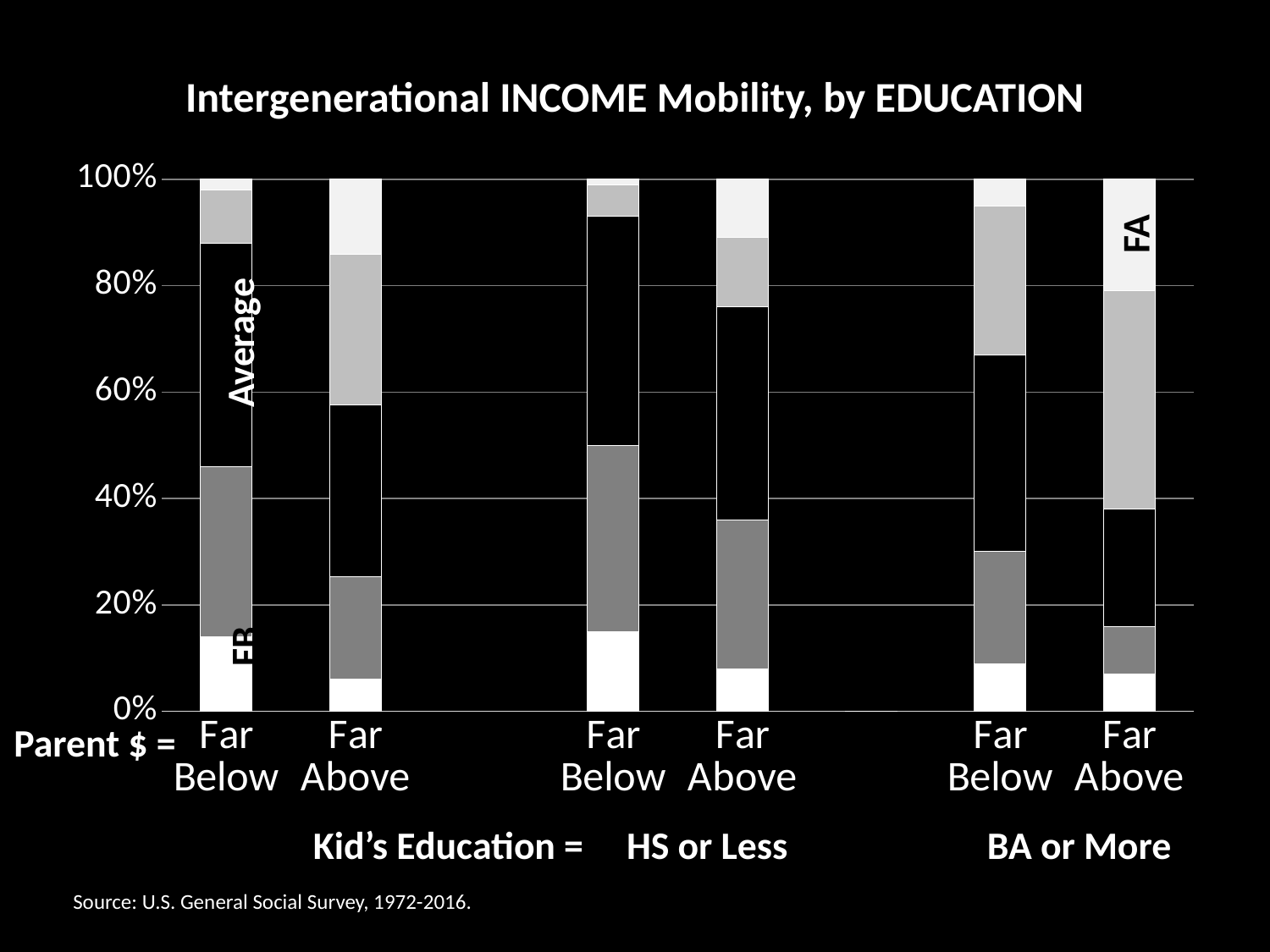
What kind of chart is shown on the slide? Stacked bar chart In the leftmost 'Far Below' bar, is the top of the black (Average) segment greater or less than 80%? greater Which bar has the larger top (FA) segment: the 'HS or Less' 'Far Above' bar or the 'BA or More' 'Far Above' bar? BA or More Far Above In the 'BA or More' 'Far Above' bar, is the top of the black (Average) segment greater or less than 60%? less How many bars are plotted in the chart? 6 What is the highest value shown on the vertical axis? 100% Which bar has the larger light gray segment: the 'HS or Less' 'Far Above' bar or the 'BA or More' 'Far Above' bar? BA or More Far Above In the 'HS or Less' 'Far Below' bar, is the top of the black (Average) segment greater or less than 80%? greater What is the title of the chart? Intergenerational INCOME Mobility, by EDUCATION Which bar has the larger white (FB) segment: the leftmost 'Far Below' bar or the leftmost 'Far Above' bar? Far Below